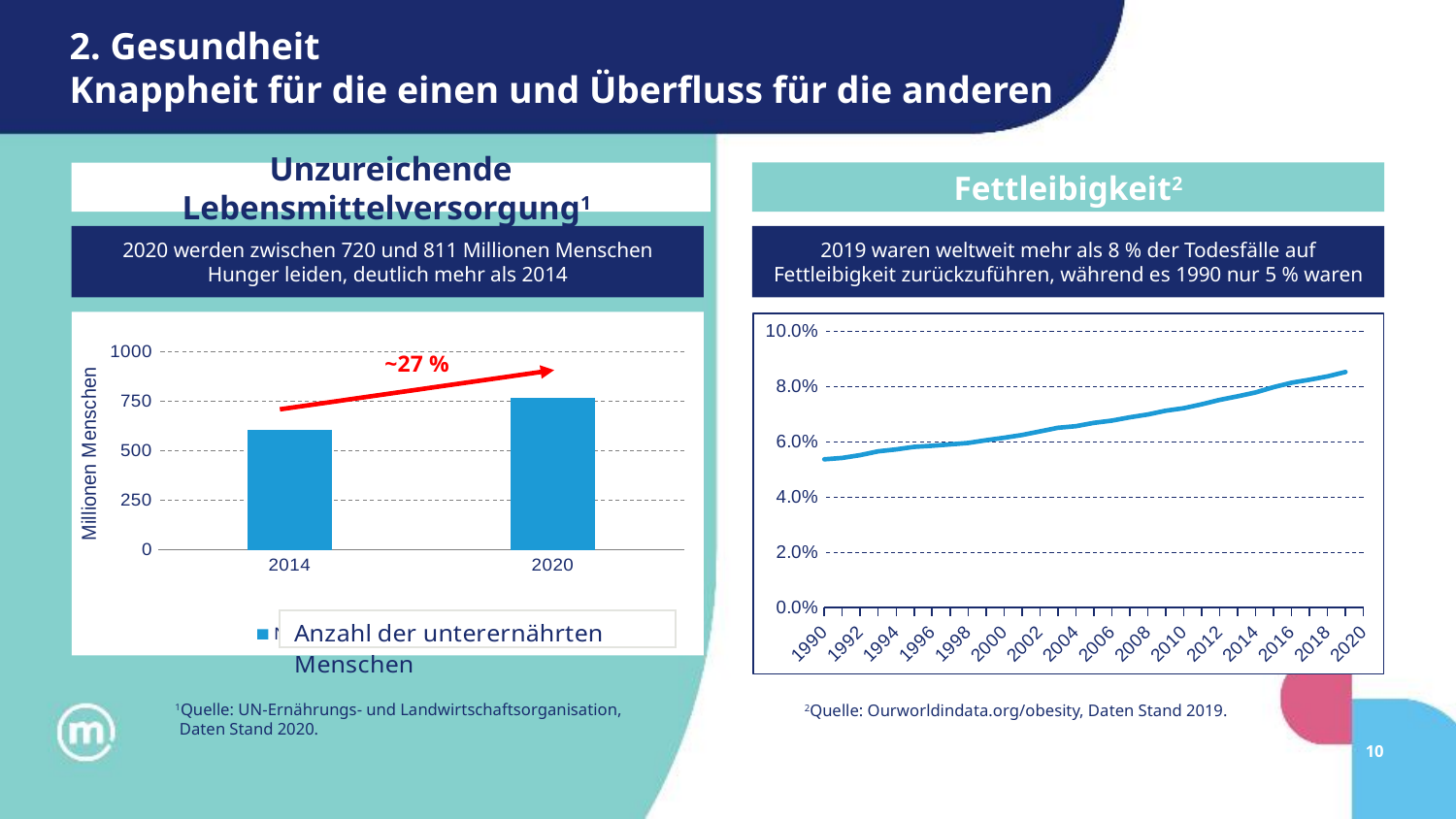
In the left bar chart, which year has the higher value? 2020 What kind of chart is the right chart titled 'Fettleibigkeit'? line chart What kind of chart is the left chart titled 'Unzureichende Lebensmittelversorgung'? bar chart In the left bar chart, is the value for 2014 greater or less than 500? greater In the left bar chart, what percentage increase is written next to the red arrow? ~27 % In the right line chart, is the value for 2018 greater or less than 8.0%? greater In the left bar chart, how many years are shown on the x axis? 2 In the right line chart, do the values rise or fall from 1990 to 2020? rise In the left bar chart, is the value for 2020 greater or less than 1000? less In the left bar chart, what is the label on the y axis? Millionen Menschen